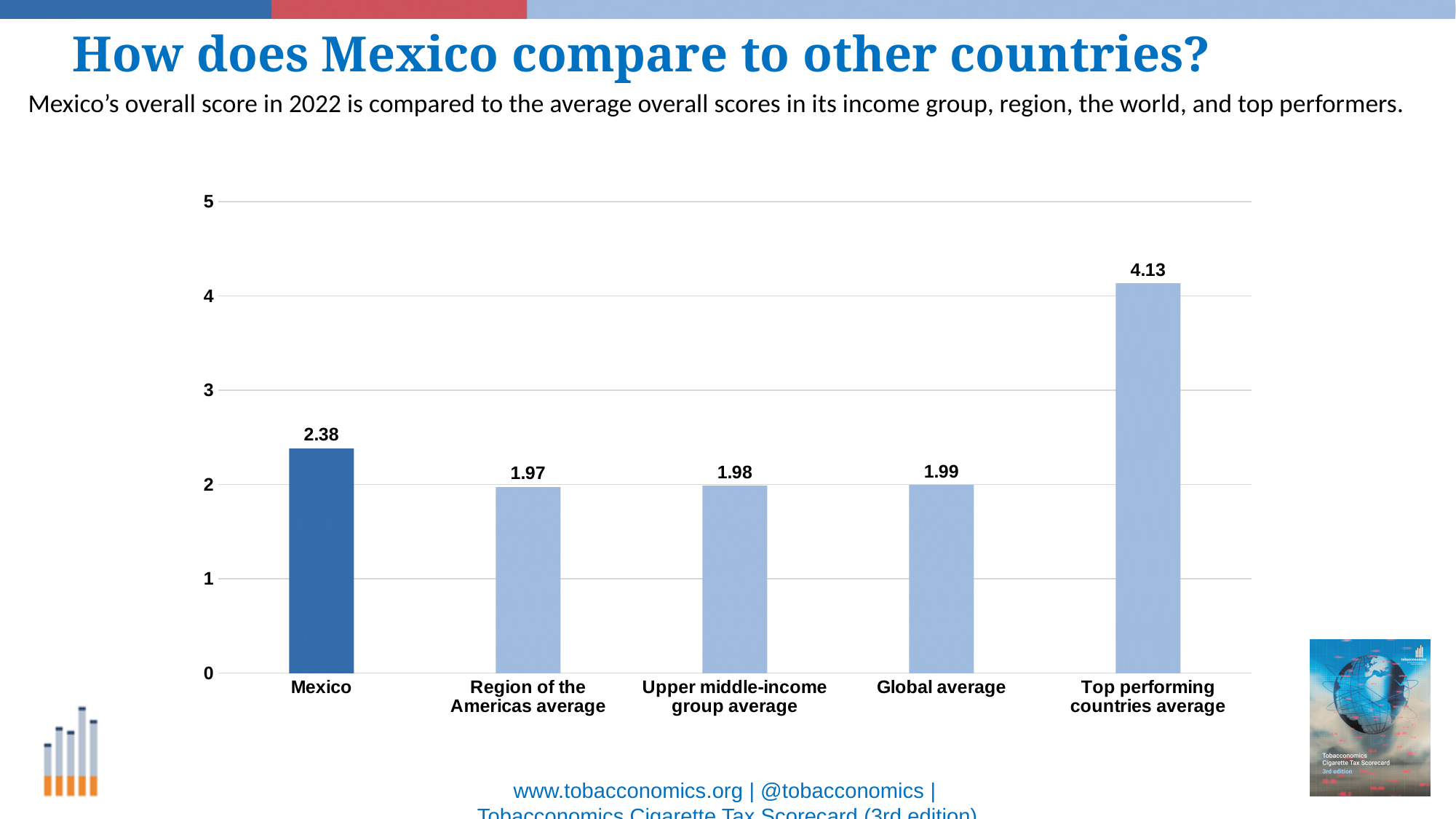
How many categories are shown in the chart? 5 What is the overall score for Mexico? 2.38 What kind of chart is shown on the slide? Bar chart Which category has the lowest value? Region of the Americas average Which is larger, Mexico's score or the Upper middle-income group average? Mexico What is the value for the Top performing countries average? 4.13 What is the value for the Region of the Americas average? 1.97 What is the value for the Global average? 1.99 Which category has the highest value? Top performing countries average What is the difference between Mexico's score and the Global average? 0.39 Which bar is shown in a darker blue than the others? Mexico What is the difference between the Top performing countries average and Mexico's score? 1.75